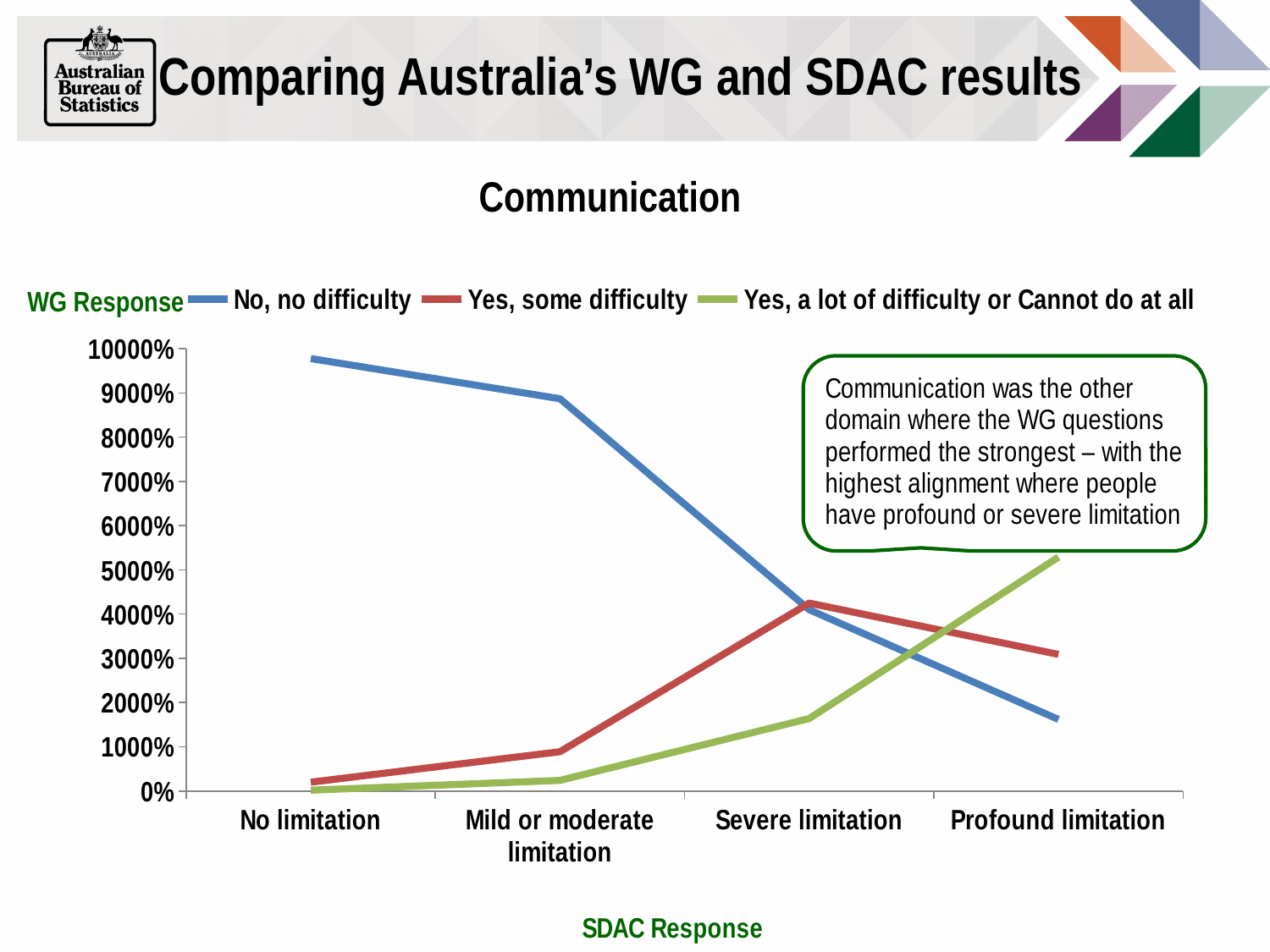
What is the title of the x axis of the chart? SDAC Response Is the value of the 'No, no difficulty' line at 'Mild or moderate limitation' greater or less than 8000%? greater At 'Profound limitation', which is higher: the 'Yes, a lot of difficulty or Cannot do at all' line or the 'No, no difficulty' line? Yes, a lot of difficulty or Cannot do at all At which SDAC Response category is the 'Yes, a lot of difficulty or Cannot do at all' line lowest? No limitation How many categories are shown on the x axis of the chart? 4 Is the value of the 'Yes, a lot of difficulty or Cannot do at all' line at 'Severe limitation' greater or less than 2000%? less Does the 'No, no difficulty' line rise or fall from 'No limitation' to 'Profound limitation'? Fall How many series does the chart legend list? 3 Is the value of the 'No, no difficulty' line at 'Profound limitation' greater or less than 2000%? less At which SDAC Response category is the 'No, no difficulty' line highest? No limitation What kind of chart is shown on the slide? Line chart